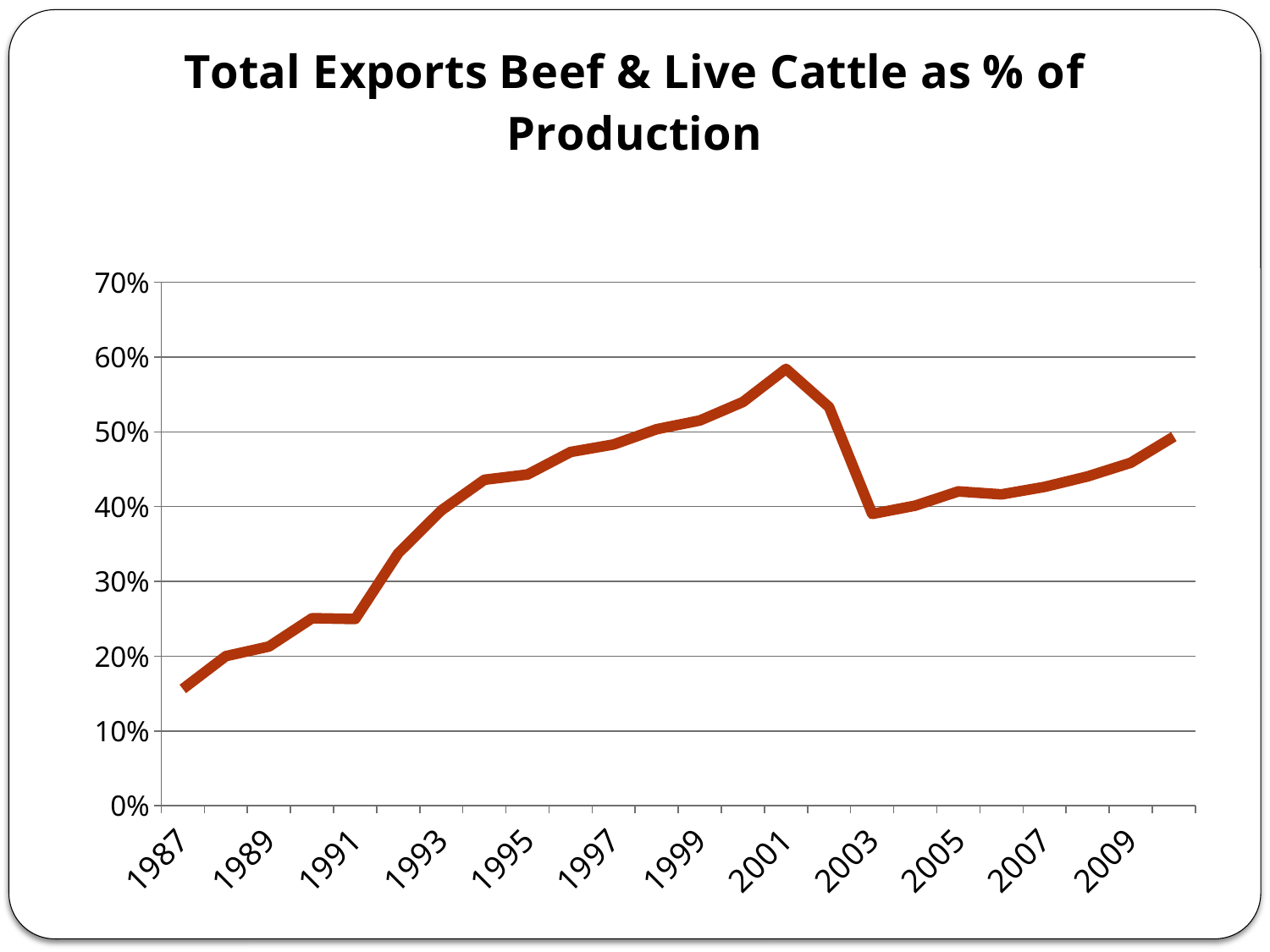
What kind of chart is shown on the slide? Line chart In which year is the value lowest? 1987 Is the value for 1991 greater or less than 30%? less Does the value rise or fall from 1987 to 2001? rise Is the value for 1987 greater or less than 20%? less In which year does the line reach its highest value? 2001 Is the value for 2007 greater or less than 50%? less How many year labels are shown on the x axis? 12 Which year has the larger value, 2001 or 2003? 2001 What is the title of the chart? Total Exports Beef & Live Cattle as % of Production